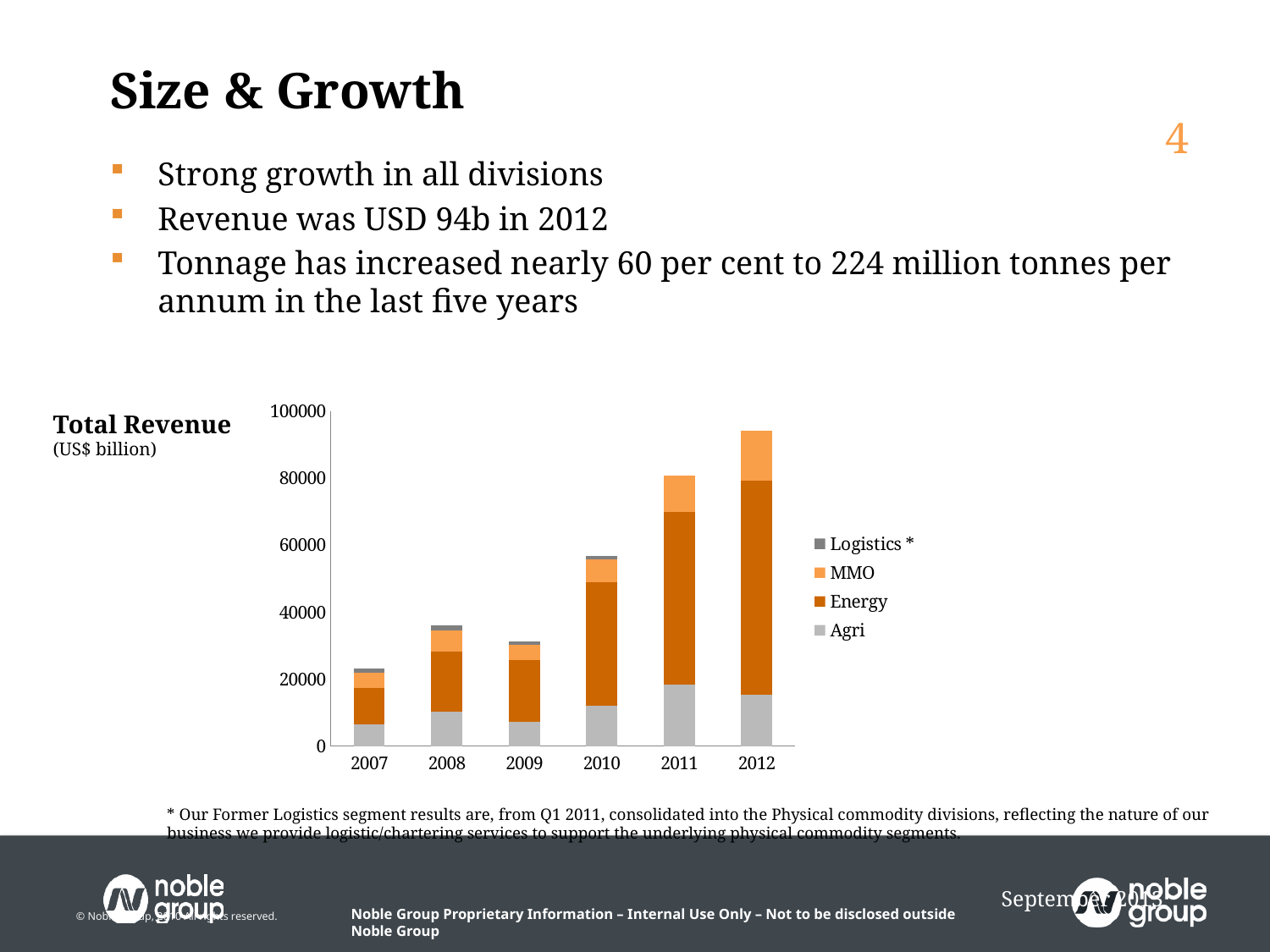
What is the title of the chart? Total Revenue Which year has the larger total revenue bar, 2009 or 2010? 2010 Is the total revenue bar for 2009 greater or less than 40000? less How many years are shown on the x axis of the Total Revenue chart? 6 Which year has the highest total revenue bar? 2012 Which year has the lowest total revenue bar? 2007 What kind of chart is shown on the slide? Stacked bar chart Is the total revenue bar for 2012 greater or less than 80000? greater Which series is shown in dark orange in the legend? Energy Is the total revenue bar for 2011 greater or less than 60000? greater Does total revenue generally rise or fall from 2007 to 2012? rise How many series does the legend of the Total Revenue chart list? 4